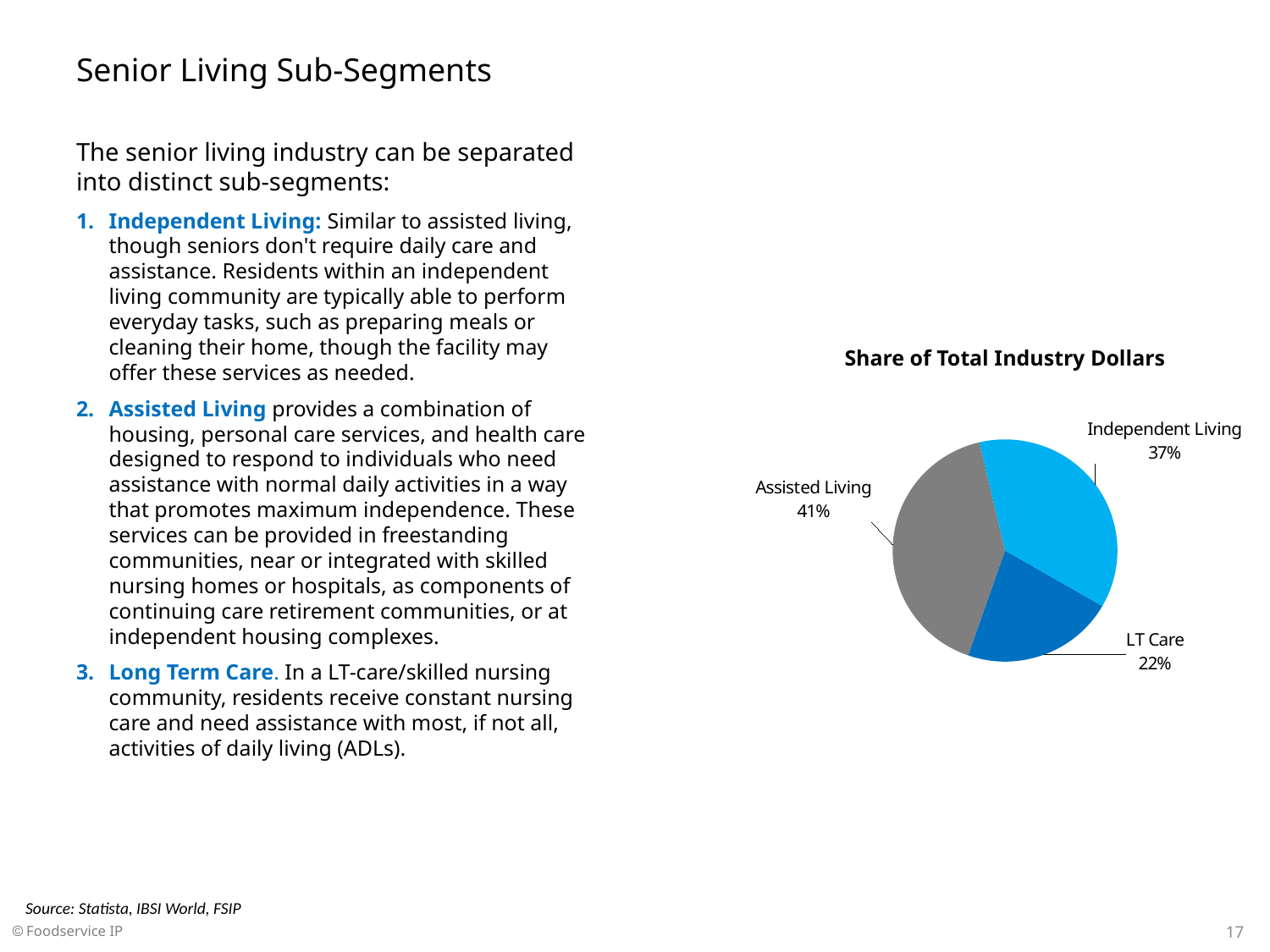
Which has a larger share of total industry dollars, Independent Living or LT Care? Independent Living Which segment has the largest share of total industry dollars? Assisted Living What is the title of the chart? Share of Total Industry Dollars What is the difference in share between Assisted Living and Independent Living? 4% What share of total industry dollars does Independent Living account for? 37% What is the difference in share between Assisted Living and LT Care? 19% Which segment has the smallest share of total industry dollars? LT Care What colour is the Assisted Living slice in the pie chart? Grey What type of chart is shown on the slide? Pie chart What share of total industry dollars does Assisted Living account for? 41% What share of total industry dollars does LT Care account for? 22% How many segments are shown in the pie chart? 3